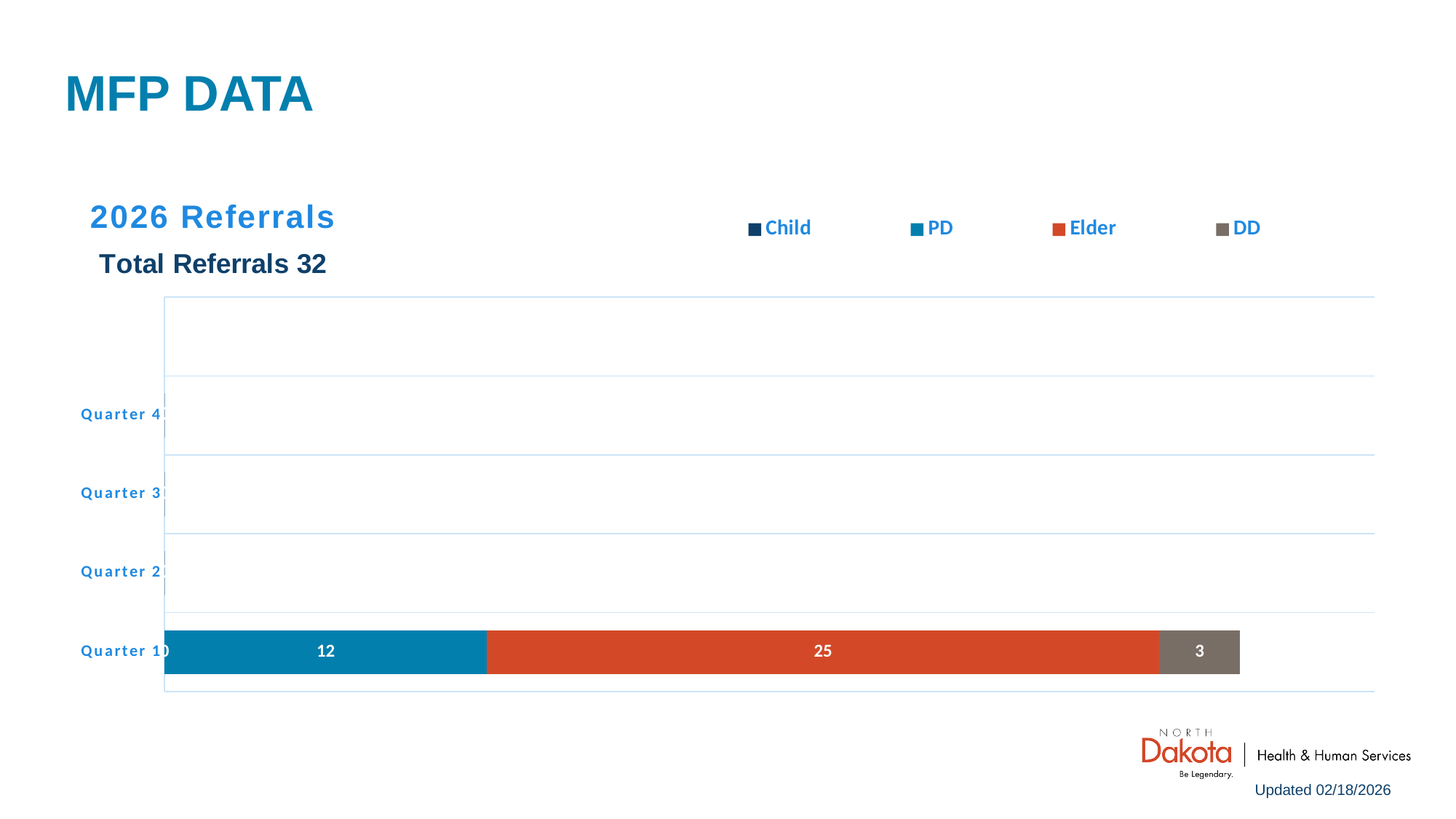
What is the difference between the Elder and PD values for Quarter 1? 13 What is the title of the chart? 2026 Referrals How many series does the legend list? 4 What is the difference between the PD and DD values for Quarter 1? 9 In Quarter 1, which is larger, the PD value or the DD value? PD Which labelled series has the smallest segment in the Quarter 1 bar? DD What kind of chart is shown on the slide? Stacked bar chart What is the Elder value for Quarter 1? 25 What is the DD value for Quarter 1? 3 What is the PD value for Quarter 1? 12 How many quarters are listed on the vertical axis? 4 Which series has the largest segment in the Quarter 1 bar? Elder